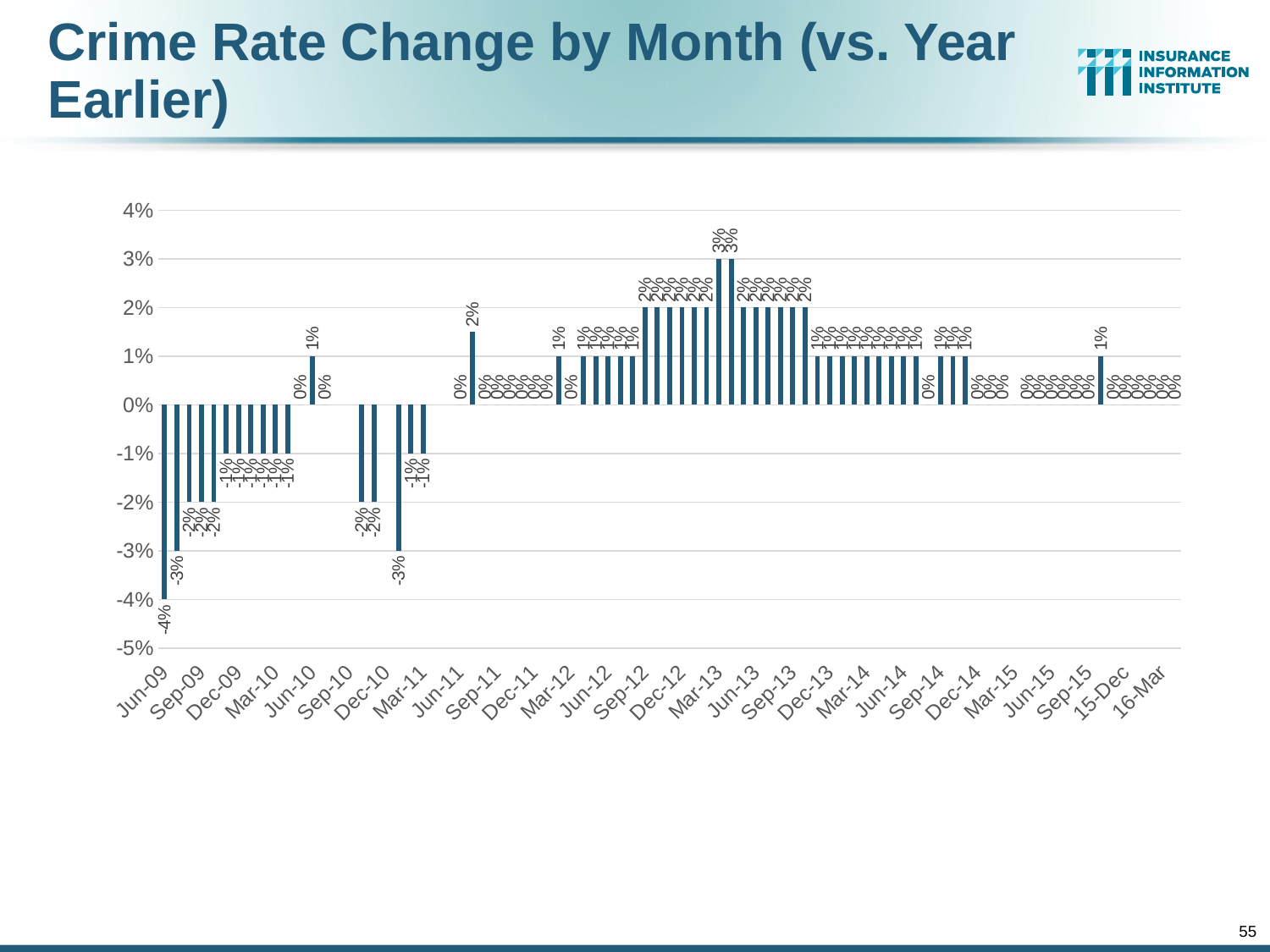
Is the value of the tallest bar on the chart greater or less than 2%? greater What is the title of the chart on the slide? Crime Rate Change by Month (vs. Year Earlier) Do the values rise or fall from Jun-09 to Jun-10? rise What is the crime rate change for Jun-09? -4% What is the highest value shown on the vertical axis? 4% How many bars on the chart are labelled 3%? 2 What is the highest crime rate change value shown on the chart? 3% What is the difference between the crime rate change for Jun-10 (1%) and Jun-09 (-4%)? 5 percentage points What kind of chart is shown on the slide? bar chart Which has the larger crime rate change, Jun-09 or Jun-10? Jun-10 What is the lowest crime rate change value shown on the chart? -4% What is the crime rate change for 16-Mar, the last bar on the chart? 0%